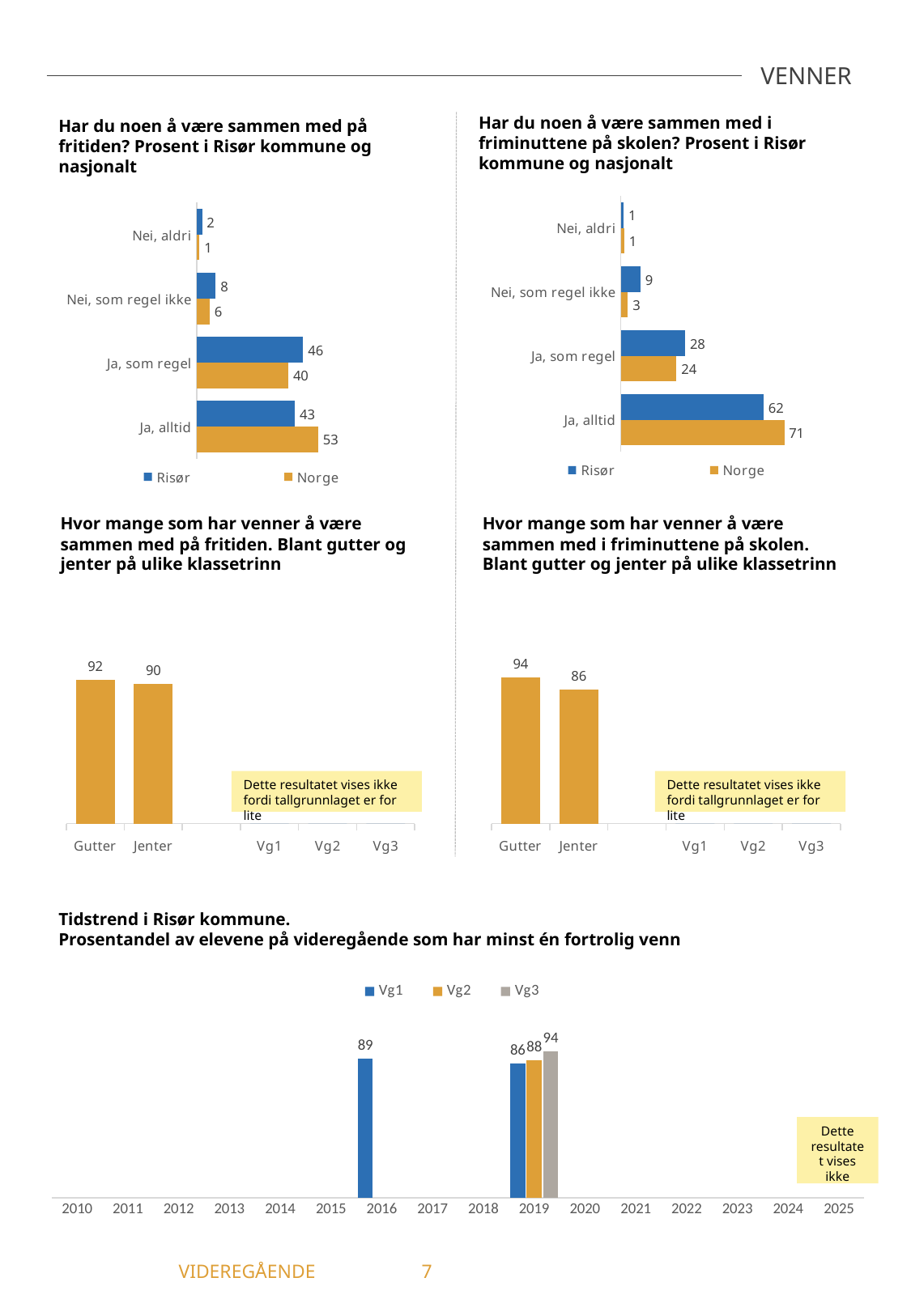
In the chart 'Har du noen å være sammen med på fritiden? Prosent i Risør kommune og nasjonalt', what is the value for Norge in the category 'Ja, alltid'? 53 In the chart 'Hvor mange som har venner å være sammen med på fritiden. Blant gutter og jenter på ulike klassetrinn', what is the value for Jenter? 90 In the chart 'Har du noen å være sammen med på fritiden? Prosent i Risør kommune og nasjonalt', which category has the lowest value for Norge? Nei, aldri In the chart 'Har du noen å være sammen med i friminuttene på skolen? Prosent i Risør kommune og nasjonalt', which is larger for 'Nei, som regel ikke': Risør or Norge? Risør What kind of chart is 'Tidstrend i Risør kommune'? Bar chart In the chart 'Har du noen å være sammen med i friminuttene på skolen? Prosent i Risør kommune og nasjonalt', what is the difference between Norge and Risør for 'Ja, alltid'? 9 In the chart 'Tidstrend i Risør kommune', what is the value for Vg3 in 2019? 94 In the chart 'Har du noen å være sammen med i friminuttene på skolen? Prosent i Risør kommune og nasjonalt', what is the value for Risør in the category 'Ja, alltid'? 62 In the chart 'Tidstrend i Risør kommune', what is the value for Vg1 in 2016? 89 In the chart 'Hvor mange som har venner å være sammen med i friminuttene på skolen. Blant gutter og jenter på ulike klassetrinn', what is the difference between Gutter and Jenter? 8 In the chart 'Har du noen å være sammen med på fritiden? Prosent i Risør kommune og nasjonalt', what is the difference between Risør and Norge for 'Ja, som regel'? 6 In the chart 'Har du noen å være sammen med i friminuttene på skolen? Prosent i Risør kommune og nasjonalt', how many series does the legend list? 2